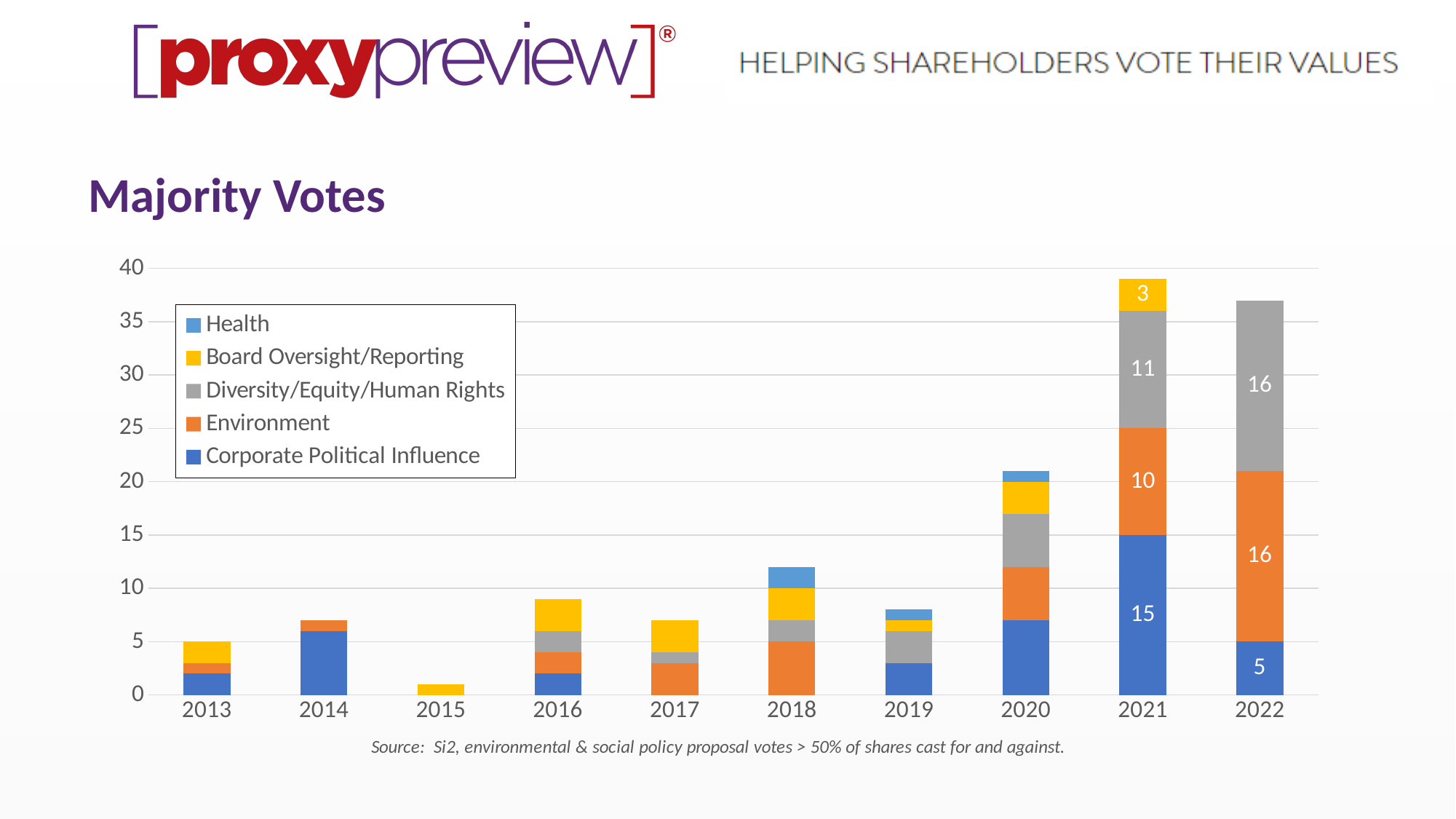
Is the total for 2020 greater or less than 15? greater What is the Corporate Political Influence value for 2021? 15 What is the title of the chart? Majority Votes How many series does the legend list? 5 What is the Board Oversight/Reporting value for 2021? 3 Which year has the lowest total stacked bar? 2015 What is the Environment value for 2022? 16 What kind of chart is shown on the slide? stacked bar chart What is the total of the stacked bar for 2022? 37 What is the difference between the Corporate Political Influence values for 2021 and 2022? 10 How many years are shown along the x axis? 10 What is the total of the stacked bar for 2021? 39